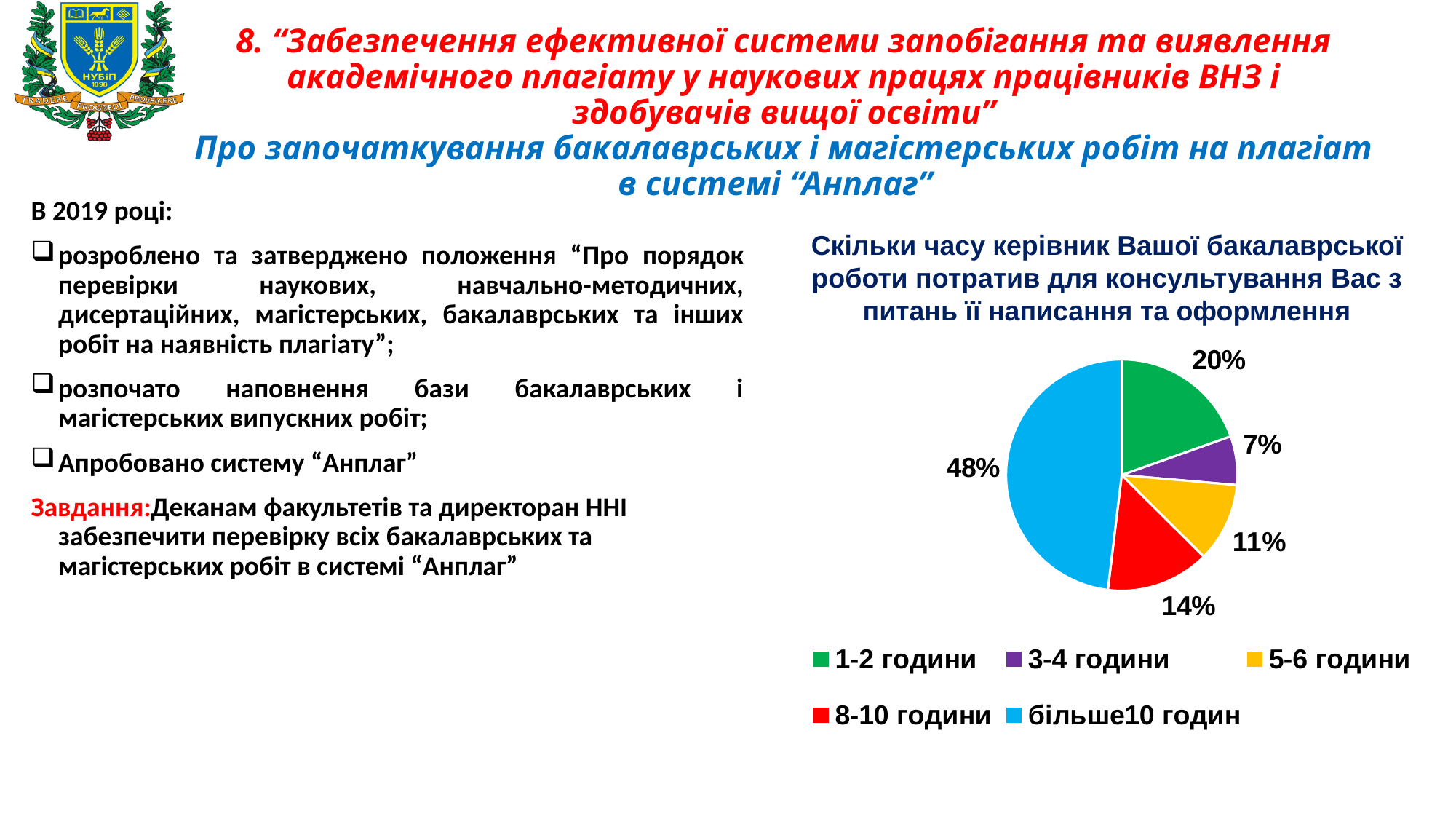
What is the value for "1-2 години" in the pie chart? 20% What is the value for "5-6 години" in the pie chart? 11% Which category has the smallest slice in the pie chart? 3-4 години What share of the pie does the "більше10 годин" slice represent? 48% What kind of chart is shown on the slide? pie chart Which is larger, the "8-10 години" slice or the "5-6 години" slice? 8-10 години What colour is the "більше10 годин" slice in the pie chart? light blue How many categories does the pie chart have? 5 Which category has the largest slice in the pie chart? більше10 годин What is the value for "8-10 години" in the pie chart? 14% What is the value for "3-4 години" in the pie chart? 7% What is the difference between the "більше10 годин" and "1-2 години" slices? 28%